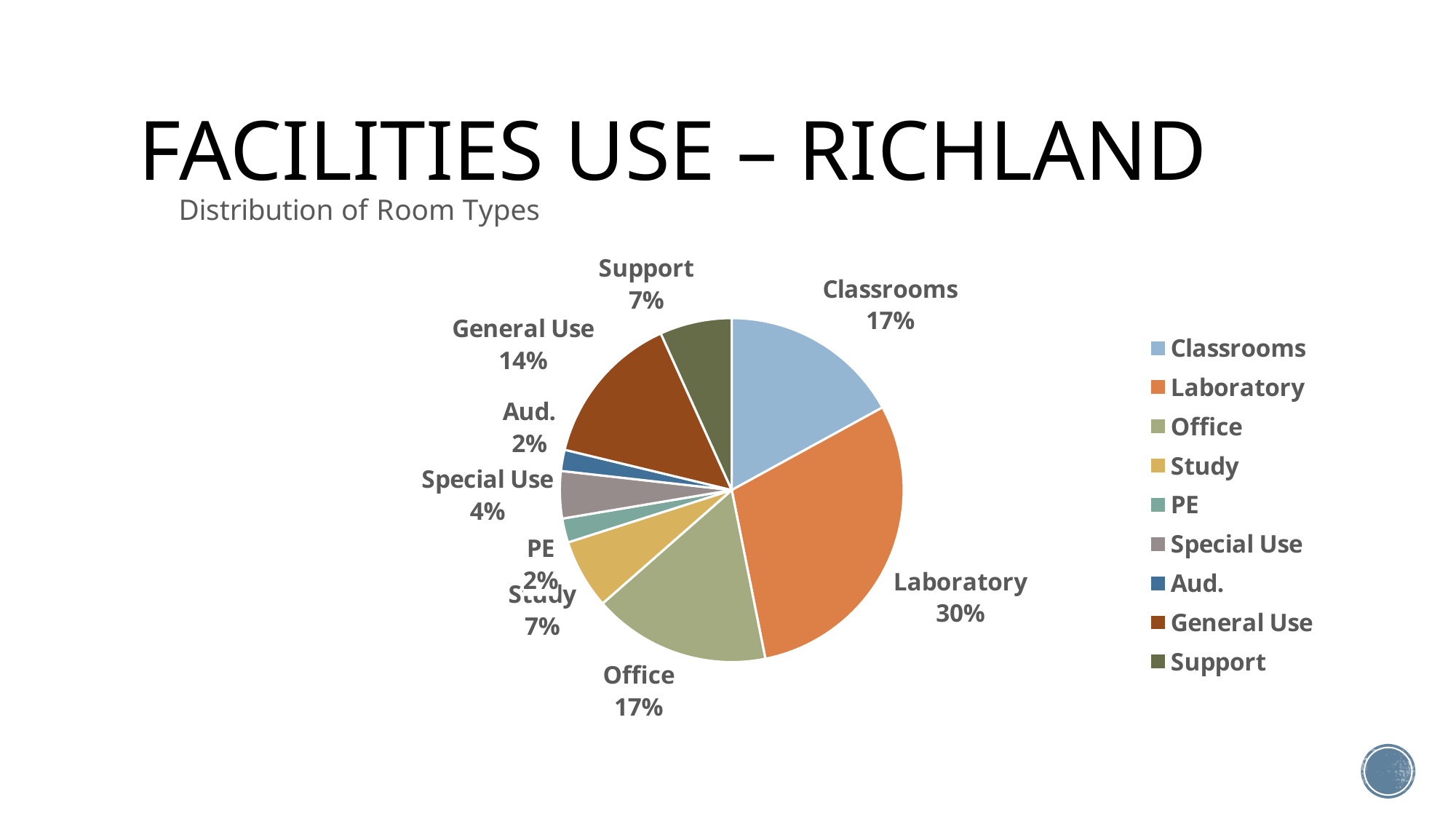
What is the difference in percentage points between Laboratory and Classrooms? 13 How many room types are listed in the legend? 9 What percentage is shown for Study? 7% Which colour represents Laboratory in the legend? Orange What type of chart is shown on the slide? Pie chart What percentage is shown for General Use? 14% What is the difference in percentage points between Office and Special Use? 13 Which room type has the largest share of the pie? Laboratory What percentage is shown for Special Use? 4% What is the chart's title? Distribution of Room Types What share of room types is Laboratory? 30% Which is larger, the share for General Use or the share for Support? General Use